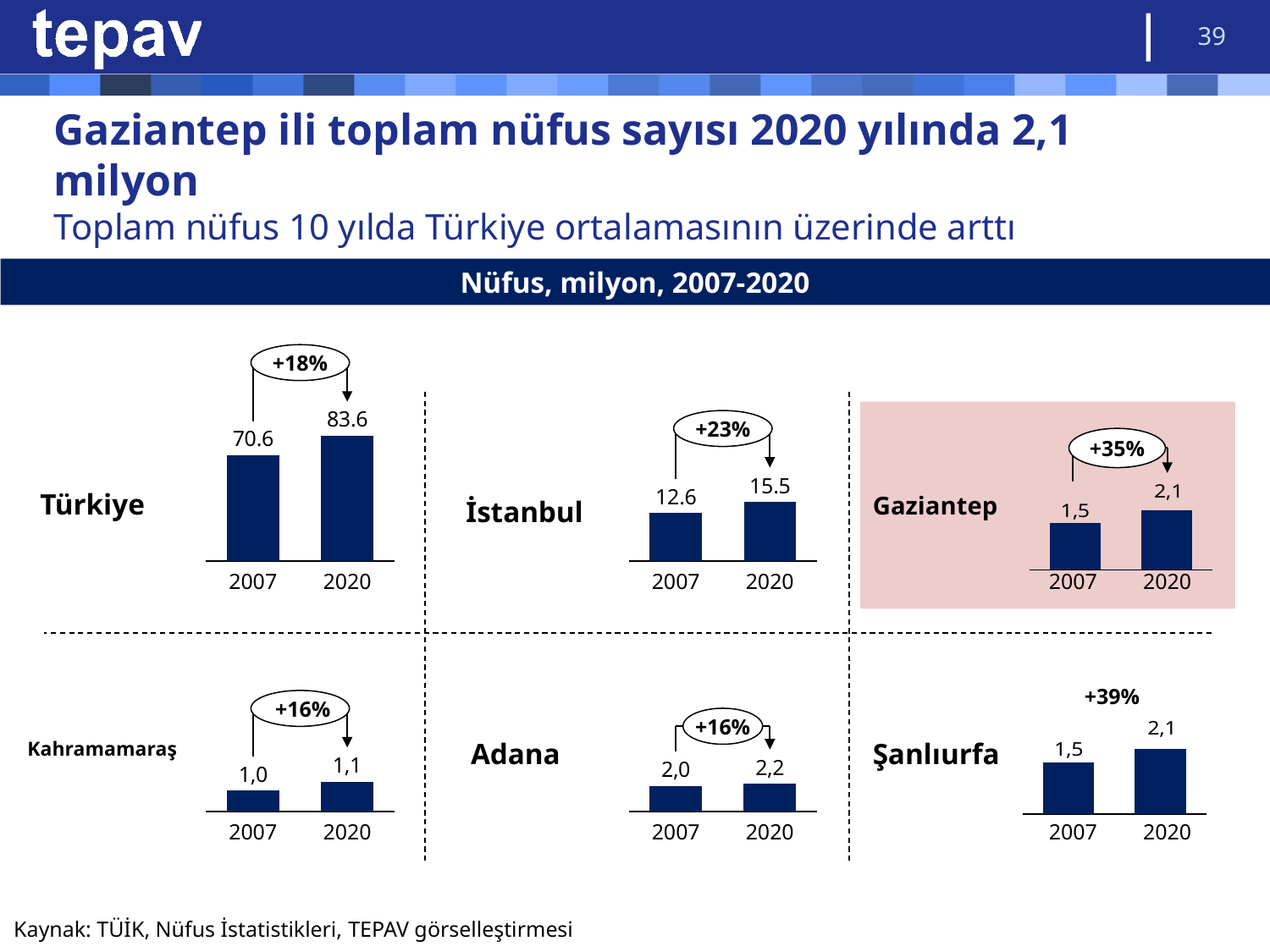
What percentage change is shown above the Şanlıurfa chart? +39% What percentage change is shown above the Gaziantep chart? +35% How many bars are shown in the Gaziantep chart? 2 What kind of chart is used for the Türkiye panel? bar chart In the İstanbul chart, what is the difference between the 2020 and 2007 values? 2.9 In the Kahramanmaraş chart, which year has the higher value, 2007 or 2020? 2020 In the İstanbul chart, what is the population value shown for 2007? 12.6 In the Gaziantep chart, what is the population value shown for 2020? 2,1 In the Türkiye chart, what is the difference between the 2020 and 2007 values? 13.0 In the Türkiye chart, what is the population value shown for 2020? 83.6 In the Şanlıurfa chart, do the values rise or fall from 2007 to 2020? rise In the Adana chart, what is the population value shown for 2007? 2,0